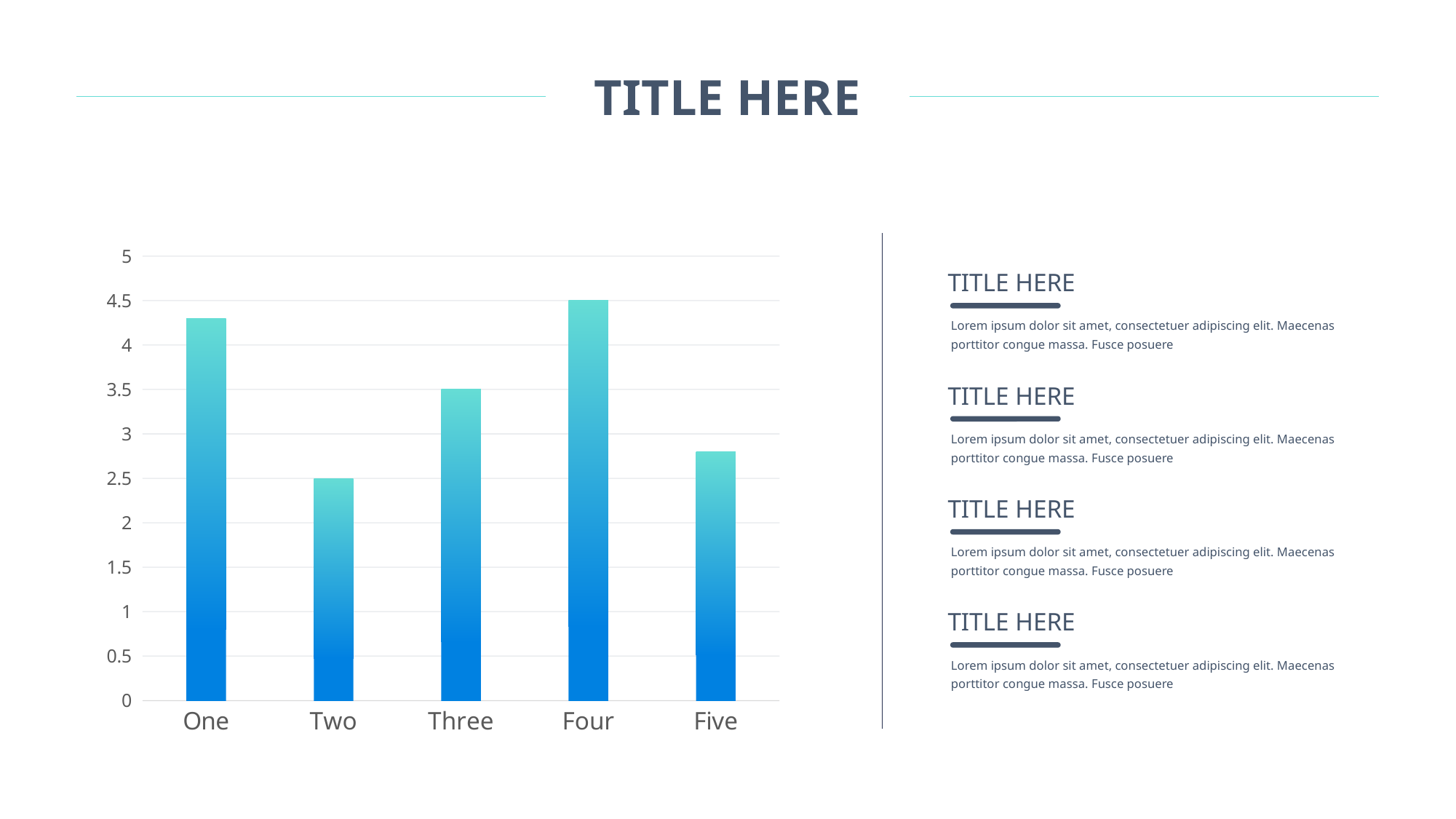
What is the value for Four in the chart? 4.5 Which is larger, the value for One or the value for Three? One What kind of chart is shown on the slide? bar chart Which category has the lowest bar in the chart? Two Is the value for One greater or less than 4? greater What is the value for Three in the chart? 3.5 Is the value for Five greater or less than 3? less Which category has the highest bar in the chart? Four What is the value for Two in the chart? 2.5 What is the title shown at the top of the slide? TITLE HERE How many categories are shown on the x axis of the chart? 5 What is the difference between the values for Four and Two? 2